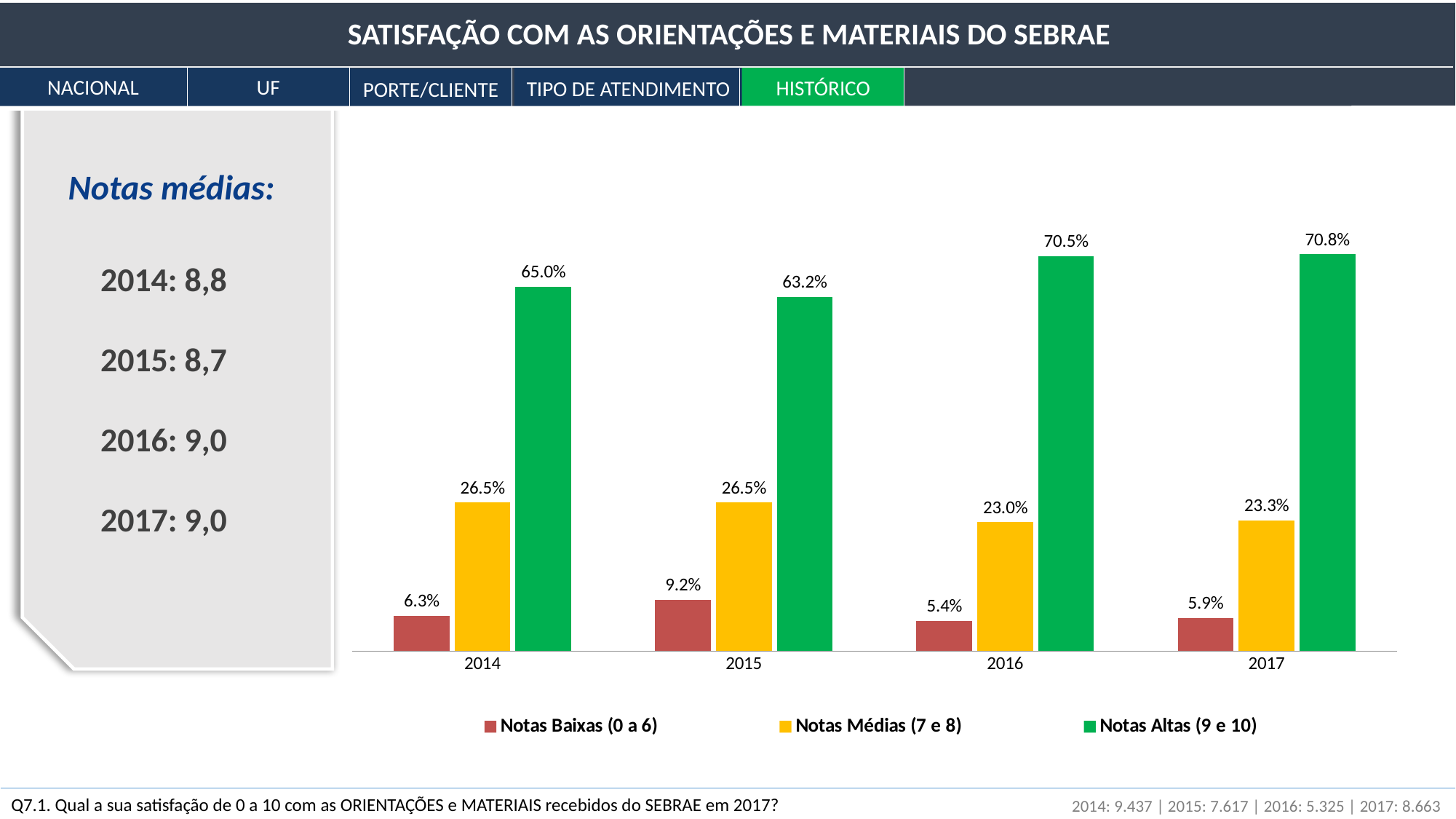
What is the value of Notas Altas (9 e 10) for 2017? 70.8% What is the value of Notas Baixas (0 a 6) for 2015? 9.2% How many years are shown on the x axis? 4 What is the value of Notas Médias (7 e 8) for 2016? 23.0% What kind of chart is shown? bar chart Which is larger: Notas Médias (7 e 8) in 2014 or in 2017? 2014 How many series does the legend list? 3 What colour represents Notas Altas (9 e 10) in the legend? green What is the difference between Notas Altas (9 e 10) in 2016 and in 2014? 5.5% Does Notas Médias (7 e 8) rise or fall from 2015 to 2017? fall In which year is Notas Altas (9 e 10) the lowest? 2015 In which year is Notas Baixas (0 a 6) the highest? 2015